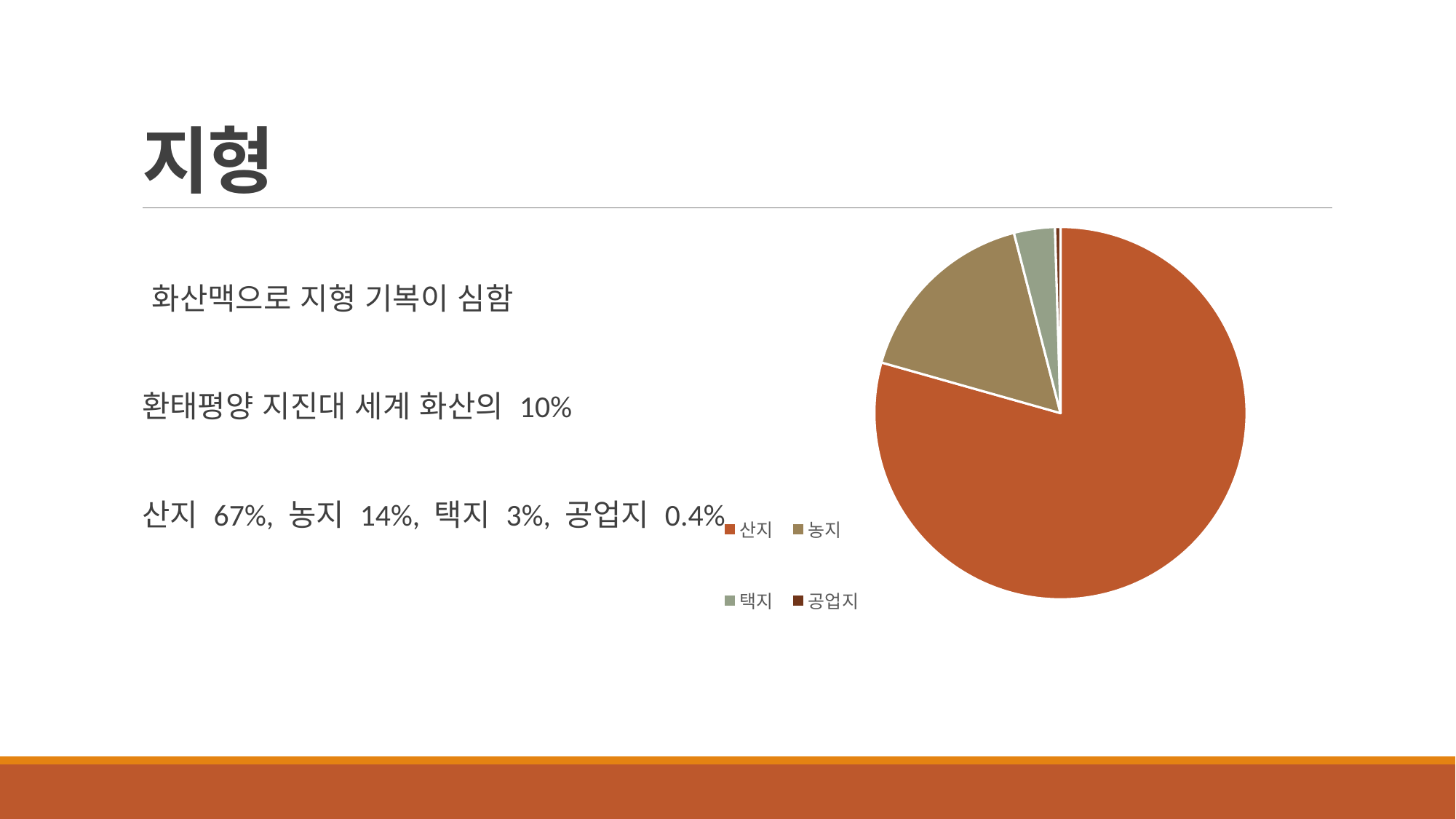
How many categories does the pie chart's legend list? 4 Which slice is larger in the pie chart, 택지 or 공업지? 택지 According to the slide, what share of the pie does 산지 represent? 67% According to the slide, what share of the pie does 택지 represent? 3% Which category has the smallest slice in the pie chart? 공업지 Which category has the largest slice in the pie chart? 산지 According to the slide, what share of the pie does 공업지 represent? 0.4% What is the difference between the shares of 산지 and 농지 given on the slide? 53% What kind of chart is shown on the slide? pie chart Which slice is larger in the pie chart, 농지 or 택지? 농지 What colour is the 산지 slice in the pie chart? orange